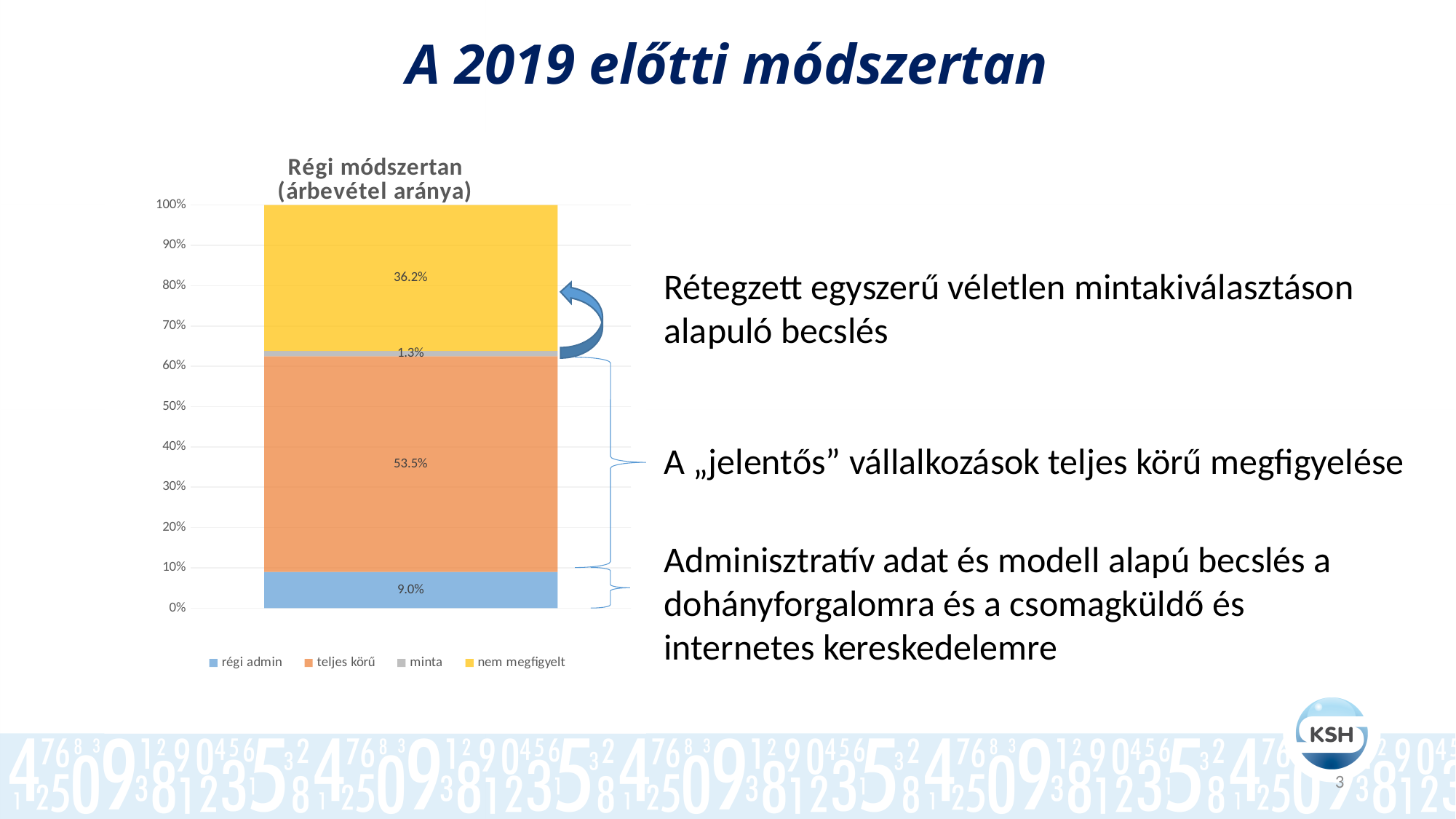
What is the value of the "régi admin" segment in the chart? 9.0% Which series has the largest share in the stacked bar? teljes körű What kind of chart is shown on the slide? stacked bar chart Which is larger, the "régi admin" value or the "minta" value? régi admin What is the value of the "teljes körű" segment in the chart? 53.5% What is the value of the "minta" segment in the chart? 1.3% Which series has the smallest share in the stacked bar? minta How many series does the legend list? 4 What is the total of the stacked bar? 100.0% What is the difference between the "teljes körű" and "nem megfigyelt" values? 17.3% What is the value of the "nem megfigyelt" segment in the chart? 36.2% What is the title of the chart? Régi módszertan (árbevétel aránya)